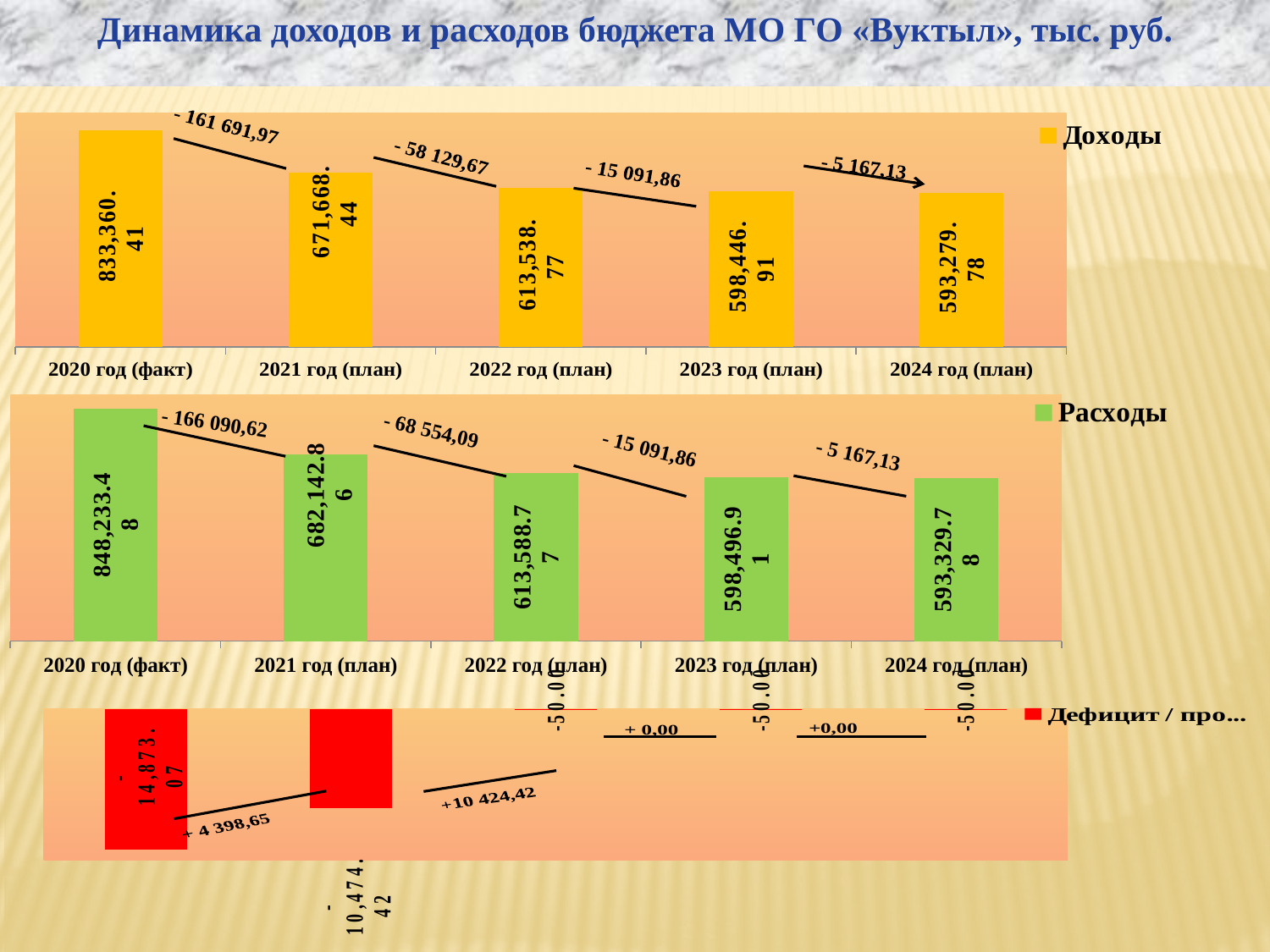
On the Доходы chart, which year has the highest value? 2020 год (факт) On the Расходы chart, which year has the lowest value? 2024 год (план) What kind of chart is the Доходы chart? bar chart On the bottom (Дефицит) chart, what is the value for 2020? -14,873.07 On the Доходы chart, what is the value for 2020 год (факт)? 833,360.41 On the Расходы chart, what is the value for 2021 год (план)? 682,142.86 On the bottom (Дефицит) chart, what is the value for 2021? -10,474.42 How many years are shown on the Расходы chart? 5 On the Доходы chart, what is the value for 2024 год (план)? 593,279.78 On the Доходы chart, do the values rise or fall from 2020 to 2024? fall For 2022 год (план), which is larger: the Доходы value or the Расходы value? Расходы On the Доходы chart, what is the difference between the 2020 год (факт) and 2021 год (план) values? 161,691.97